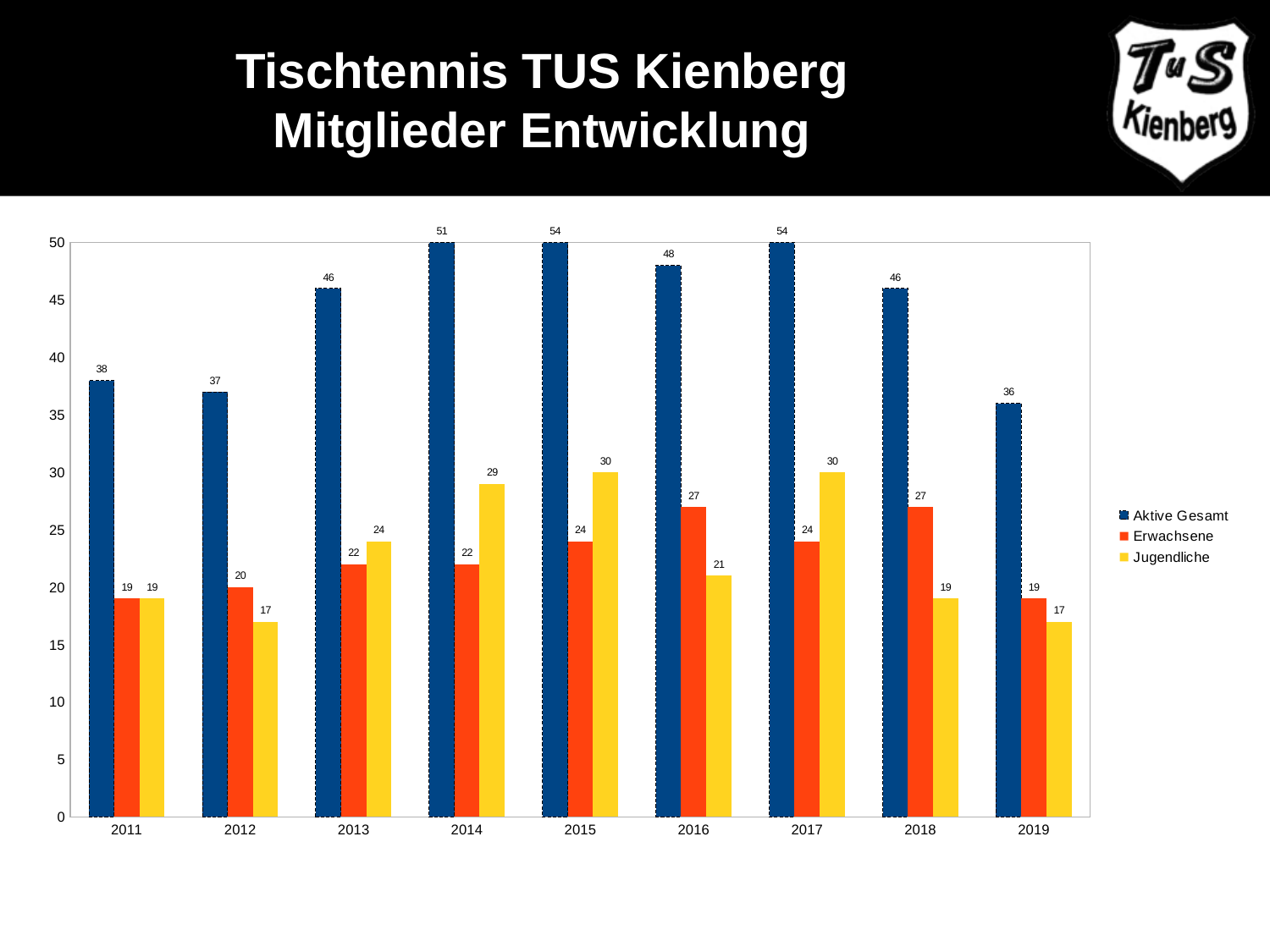
Which colour represents Erwachsene in the legend? Orange How many series does the legend list? 3 Does Jugendliche rise or fall from 2017 to 2019? Fall What is the value for Aktive Gesamt in 2014? 51 What is the value for Erwachsene in 2018? 27 In which year is Aktive Gesamt lowest? 2019 Which is larger in 2013: Erwachsene or Jugendliche? Jugendliche What kind of chart is shown on the slide? Bar chart What is the difference between Aktive Gesamt in 2017 and in 2019? 18 How many years are shown on the x axis? 9 What is the value for Jugendliche in 2015? 30 In which year is Erwachsene highest? 2016 and 2018